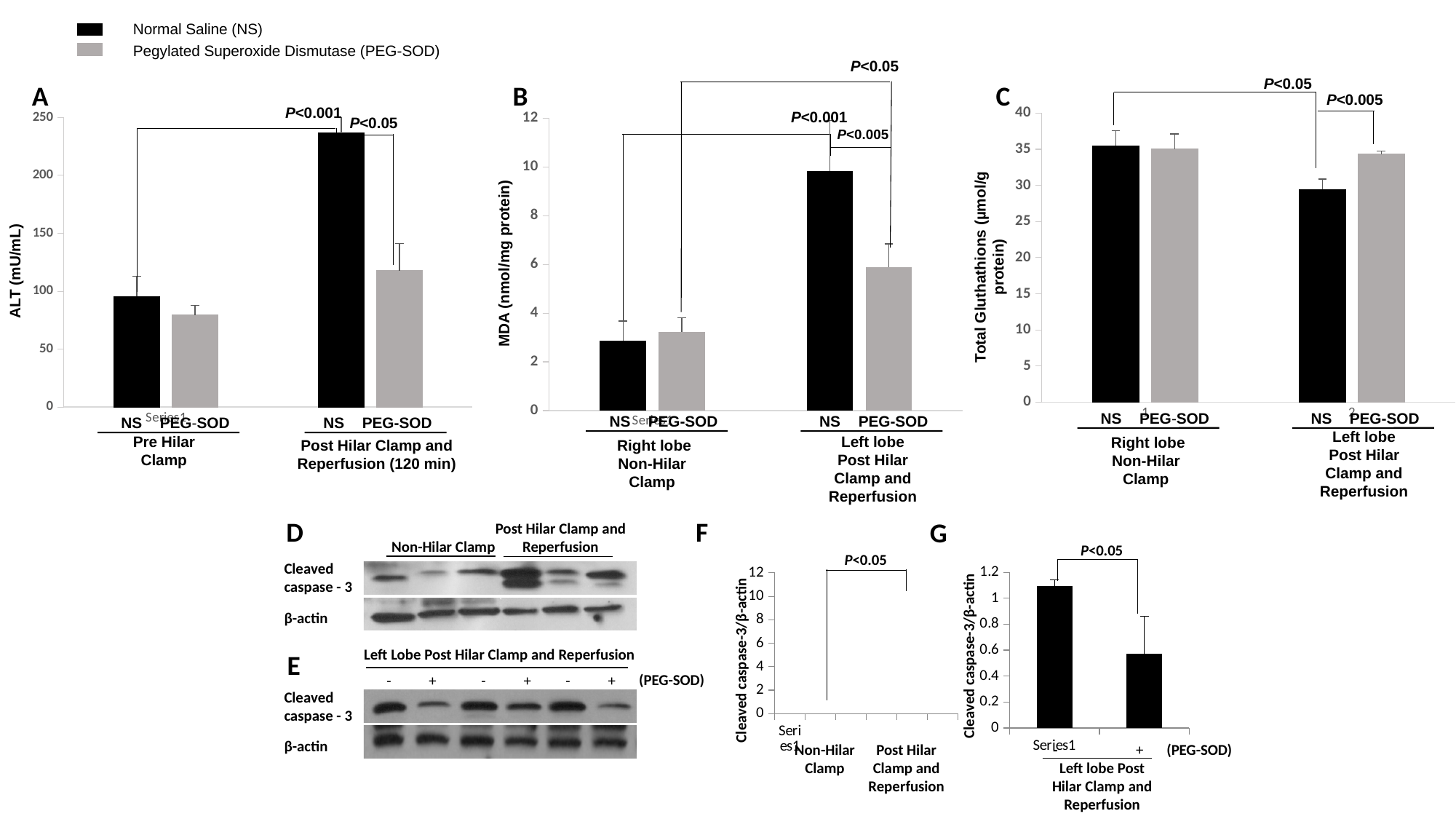
What is the y-axis label of chart A? ALT (mU/mL) In chart B (MDA), which bar is the highest? NS, Left lobe Post Hilar Clamp and Reperfusion How many series does the legend at the top of the slide list? 2 In chart A (ALT), is the NS value for Post Hilar Clamp and Reperfusion (120 min) greater or less than 200? greater What kind of chart is chart A (ALT)? bar chart In chart A (ALT), which bar is the highest? NS, Post Hilar Clamp and Reperfusion (120 min) In chart C (Total Gluthathions), is the PEG-SOD value for Left lobe Post Hilar Clamp and Reperfusion greater or less than 30? greater In chart C (Total Gluthathions), which bar is the lowest? NS, Left lobe Post Hilar Clamp and Reperfusion In chart A (ALT), is the PEG-SOD value for Pre Hilar Clamp greater or less than 100? less In chart B (MDA), for Left lobe Post Hilar Clamp and Reperfusion, which is larger: NS or PEG-SOD? NS